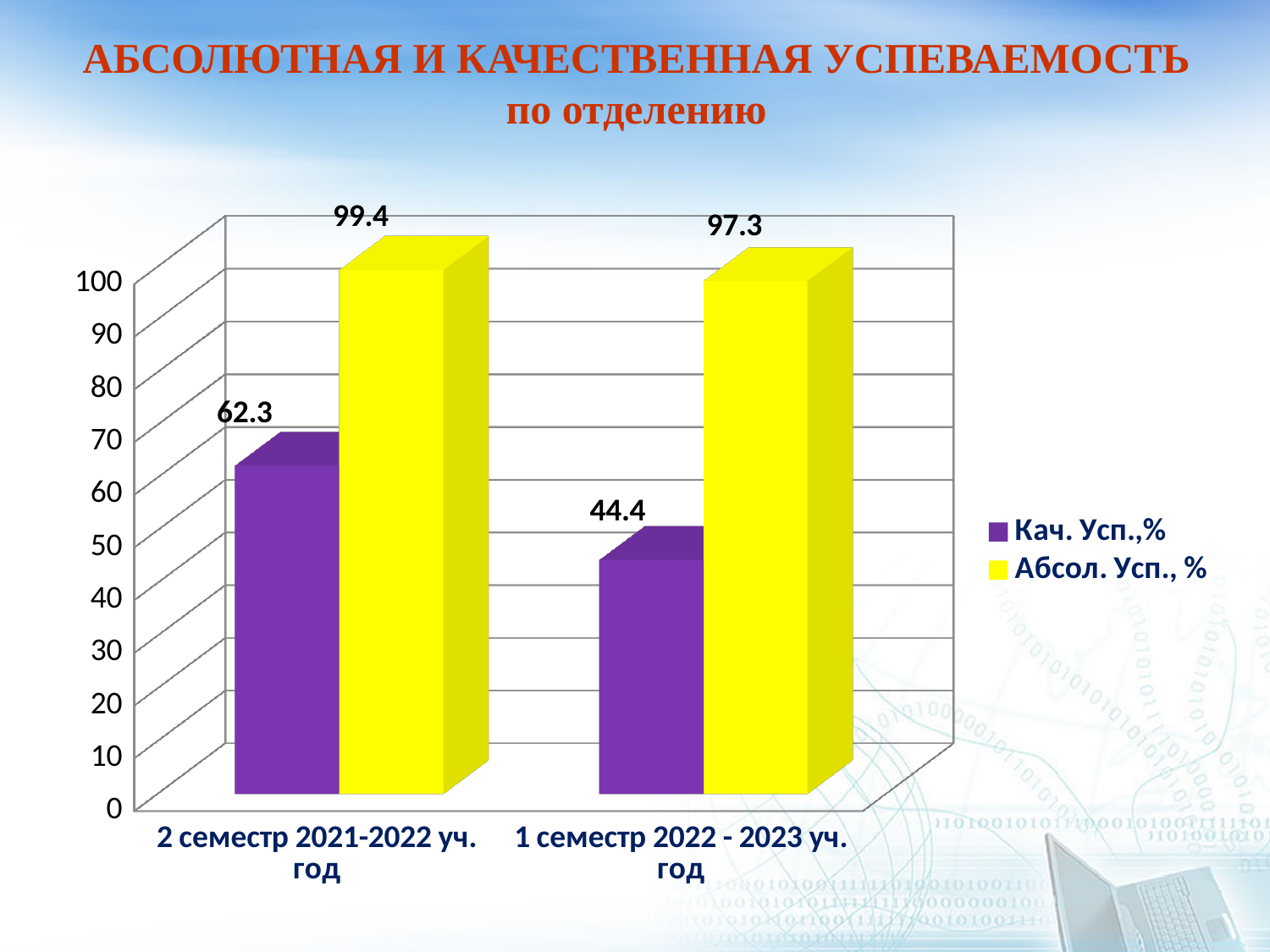
What is the value of Абсол. Усп., % for 2 семестр 2021-2022 уч. год? 99.4 What is the value of Кач. Усп.,% for 1 семестр 2022 - 2023 уч. год? 44.4 How many categories are shown on the x axis? 2 Which category has the lowest value for Абсол. Усп., %? 1 семестр 2022 - 2023 уч. год What is the value of Кач. Усп.,% for 2 семестр 2021-2022 уч. год? 62.3 What is the difference between the Кач. Усп.,% values for 2 семестр 2021-2022 уч. год and 1 семестр 2022 - 2023 уч. год? 17.9 What is the difference between the Абсол. Усп., % values for 2 семестр 2021-2022 уч. год and 1 семестр 2022 - 2023 уч. год? 2.1 How many series does the legend list? 2 What is the value of Абсол. Усп., % for 1 семестр 2022 - 2023 уч. год? 97.3 Which category has the highest value for Кач. Усп.,%? 2 семестр 2021-2022 уч. год What kind of chart is shown on the slide? Bar chart Which is larger: Кач. Усп.,% for 2 семестр 2021-2022 уч. год or Кач. Усп.,% for 1 семестр 2022 - 2023 уч. год? 2 семестр 2021-2022 уч. год